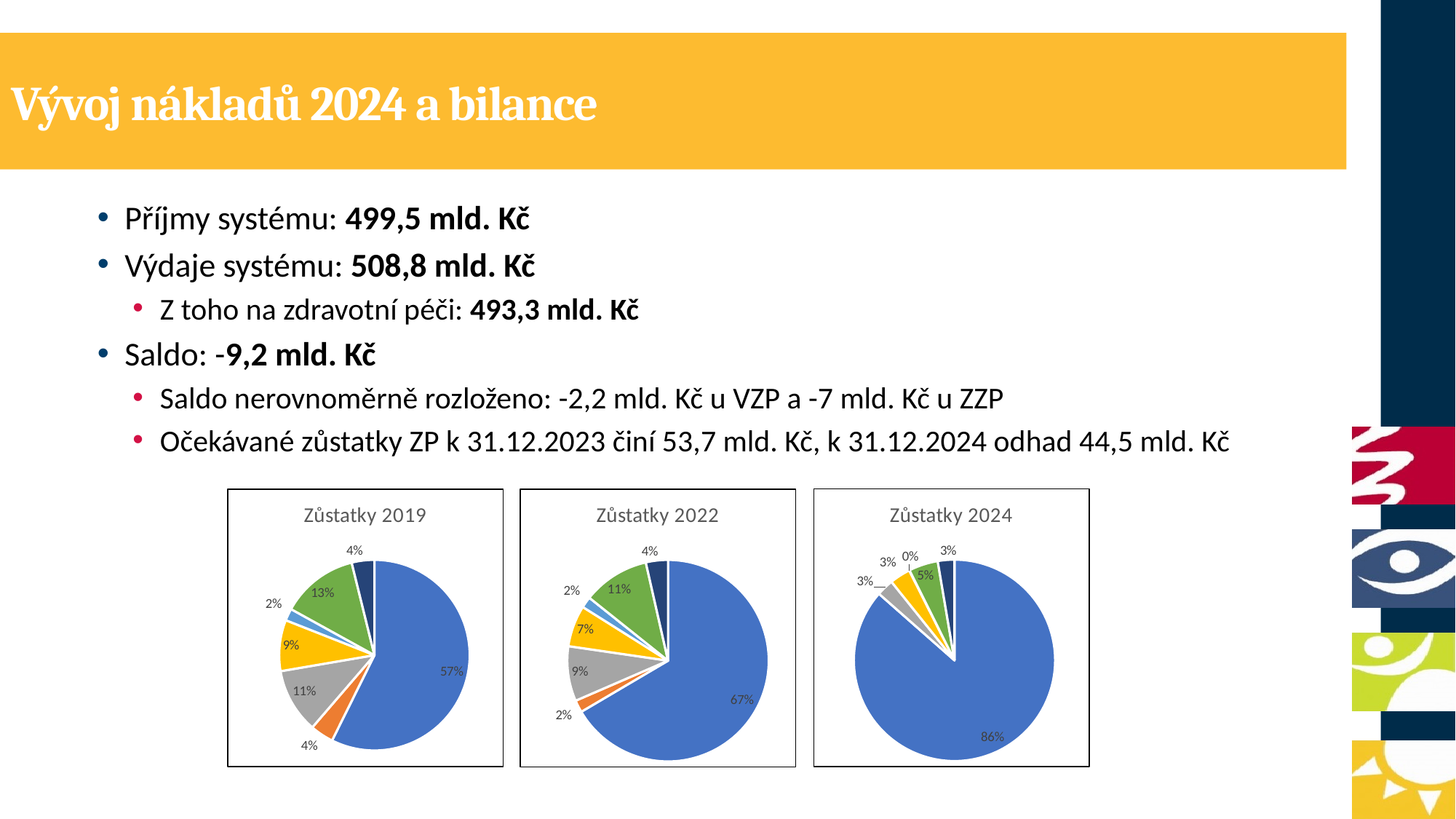
In the "Zůstatky 2022" pie chart, what share does the yellow slice have? 7% In the "Zůstatky 2024" pie chart, what share does the green slice have? 5% In the "Zůstatky 2022" pie chart, what share does the largest slice have? 67% In the "Zůstatky 2022" pie chart, what is the smallest share shown on a slice label? 2% In the "Zůstatky 2019" pie chart, what share does the green slice have? 13% In the "Zůstatky 2024" pie chart, what share does the largest slice have? 86% How many pie charts are shown on the slide? 3 What kind of chart is "Zůstatky 2019"? pie chart How many slices does the "Zůstatky 2019" pie chart have? 7 In the "Zůstatky 2019" pie chart, what share does the largest slice have? 57% Which pie chart has the largest single slice: "Zůstatky 2019", "Zůstatky 2022" or "Zůstatky 2024"? Zůstatky 2024 What is the difference between the largest slice in "Zůstatky 2024" and the largest slice in "Zůstatky 2019"? 29%